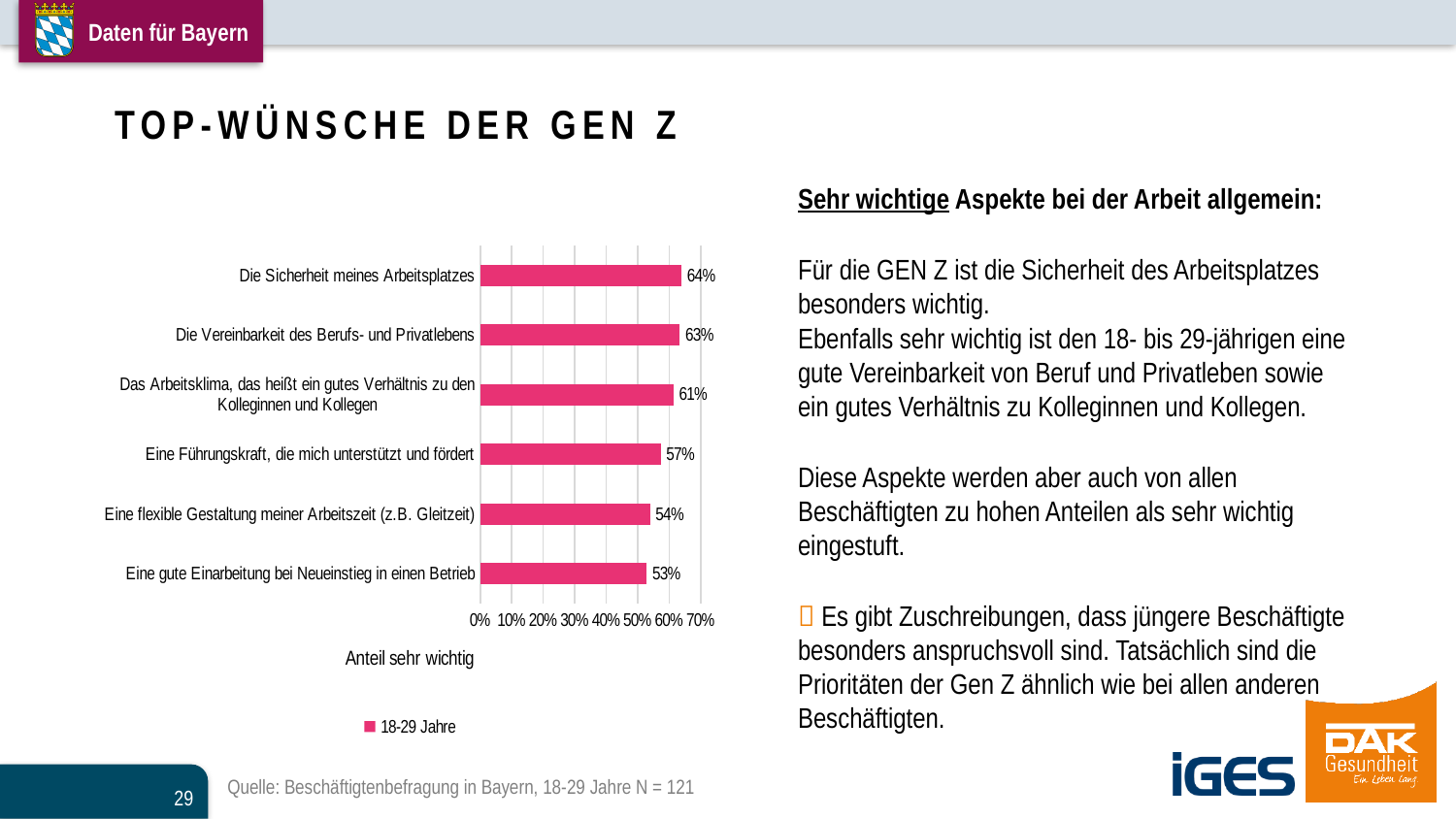
How many series does the legend list? 1 What is the value for "Eine Führungskraft, die mich unterstützt und fördert"? 57% What is the value for "Eine flexible Gestaltung meiner Arbeitszeit (z.B. Gleitzeit)"? 54% What is the value for "Die Sicherheit meines Arbeitsplatzes"? 64% Is the value for "Die Vereinbarkeit des Berufs- und Privatlebens" greater or less than 50%? greater How many categories are shown in the chart? 6 Which is larger: the value for "Das Arbeitsklima, das heißt ein gutes Verhältnis zu den Kolleginnen und Kollegen" or for "Eine flexible Gestaltung meiner Arbeitszeit (z.B. Gleitzeit)"? Das Arbeitsklima, das heißt ein gutes Verhältnis zu den Kolleginnen und Kollegen What kind of chart is shown on the slide? bar chart Which category has the highest value? Die Sicherheit meines Arbeitsplatzes What is the difference between the values for "Die Sicherheit meines Arbeitsplatzes" and "Eine gute Einarbeitung bei Neueinstieg in einen Betrieb"? 11% What is the legend entry of the chart? 18-29 Jahre Which category has the lowest value? Eine gute Einarbeitung bei Neueinstieg in einen Betrieb